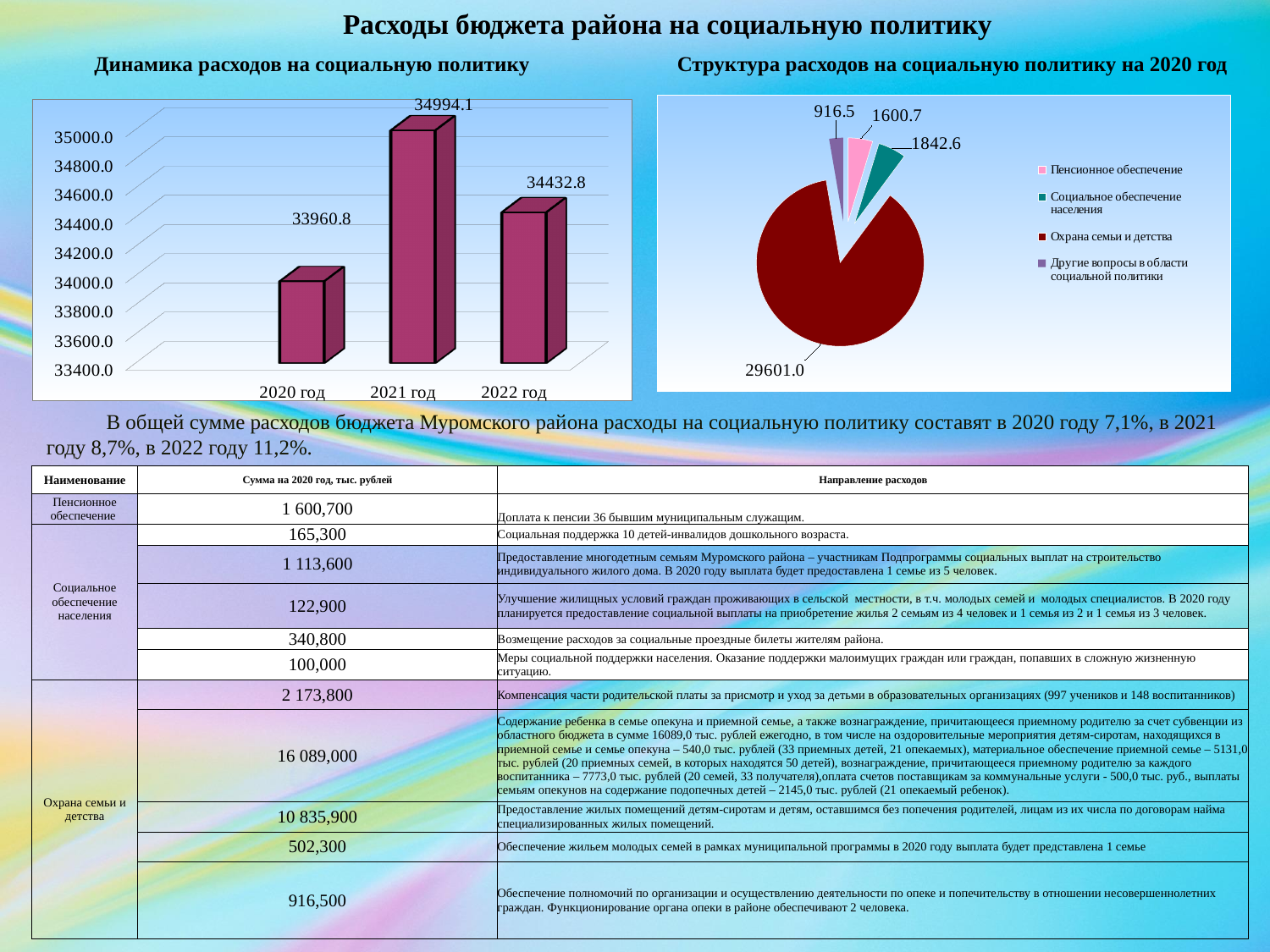
In the chart 'Динамика расходов на социальную политику', which year has the highest value? 2021 год In the chart 'Динамика расходов на социальную политику', which year has the lowest value? 2020 год In the chart 'Динамика расходов на социальную политику', what is the difference between the values for 2021 год and 2020 год? 1033.3 In the chart 'Динамика расходов на социальную политику', how many years are plotted? 3 How many categories does the legend of the pie chart 'Структура расходов на социальную политику на 2020 год' list? 4 In the chart 'Динамика расходов на социальную политику', what is the value for 2021 год? 34994.1 What kind of chart is 'Динамика расходов на социальную политику'? Bar chart In the pie chart 'Структура расходов на социальную политику на 2020 год', what is the value for Охрана семьи и детства? 29601.0 In the pie chart 'Структура расходов на социальную политику на 2020 год', which category has the smallest slice? Другие вопросы в области социальной политики In the pie chart 'Структура расходов на социальную политику на 2020 год', what is the value for Пенсионное обеспечение? 1600.7 In the chart 'Динамика расходов на социальную политику', which is larger, the value for 2022 год or the value for 2020 год? 2022 год In the chart 'Динамика расходов на социальную политику', what is the value for 2020 год? 33960.8